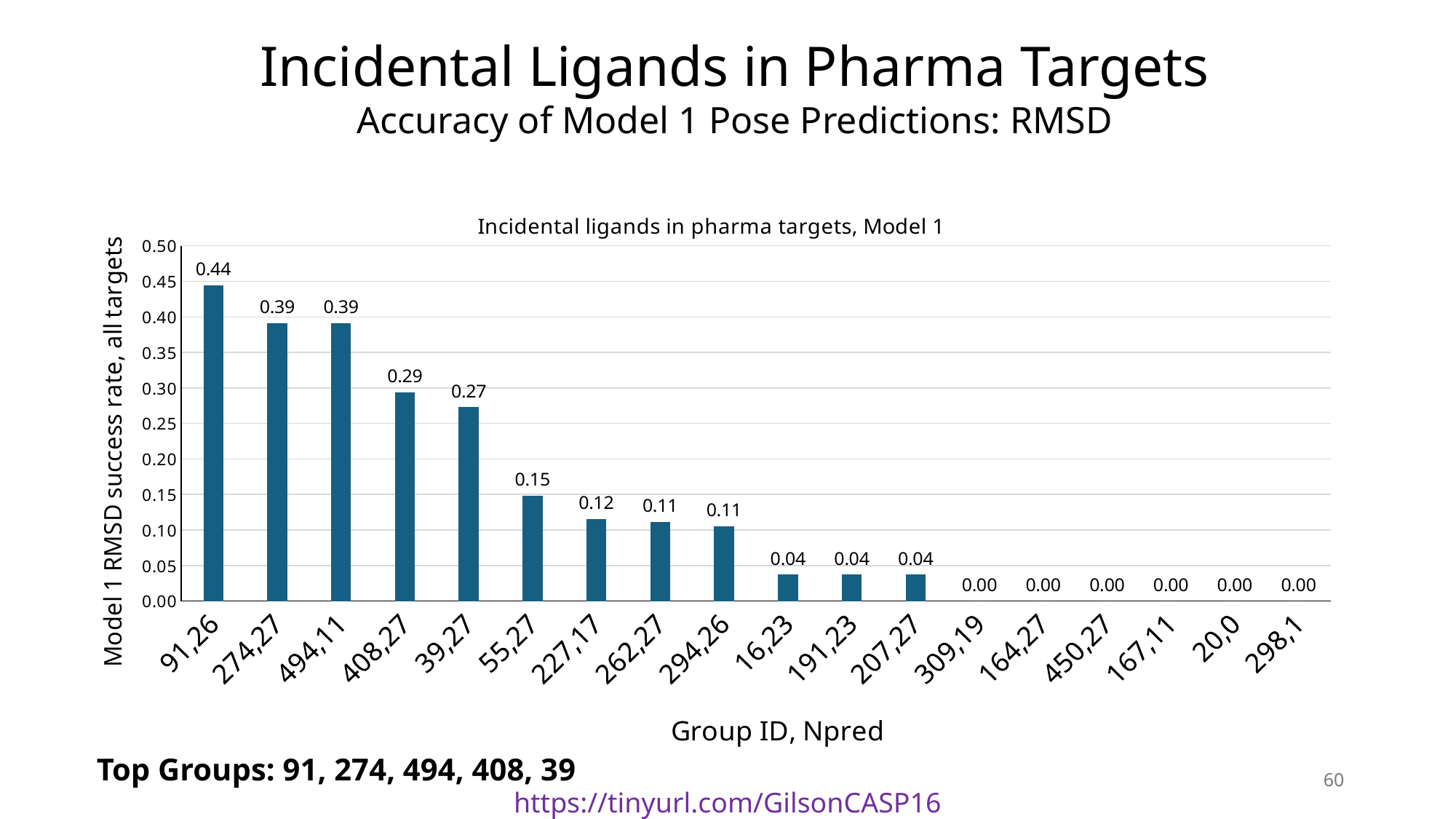
What kind of chart is shown on the slide? bar chart What is the title of the chart? Incidental ligands in pharma targets, Model 1 What is the Model 1 RMSD success rate for group 408,27? 0.29 What is the difference between the success rates of group 91,26 and group 39,27? 0.17 What is the Model 1 RMSD success rate for group 91,26? 0.44 Which group has the highest Model 1 RMSD success rate? 91,26 Do the success rates rise or fall from left to right along the x axis? fall What is the Model 1 RMSD success rate for group 16,23? 0.04 Which has a higher success rate, group 408,27 or group 294,26? 408,27 What is the difference between the success rates of group 55,27 and group 227,17? 0.03 What is the Model 1 RMSD success rate for group 55,27? 0.15 How many groups are shown on the x axis? 18